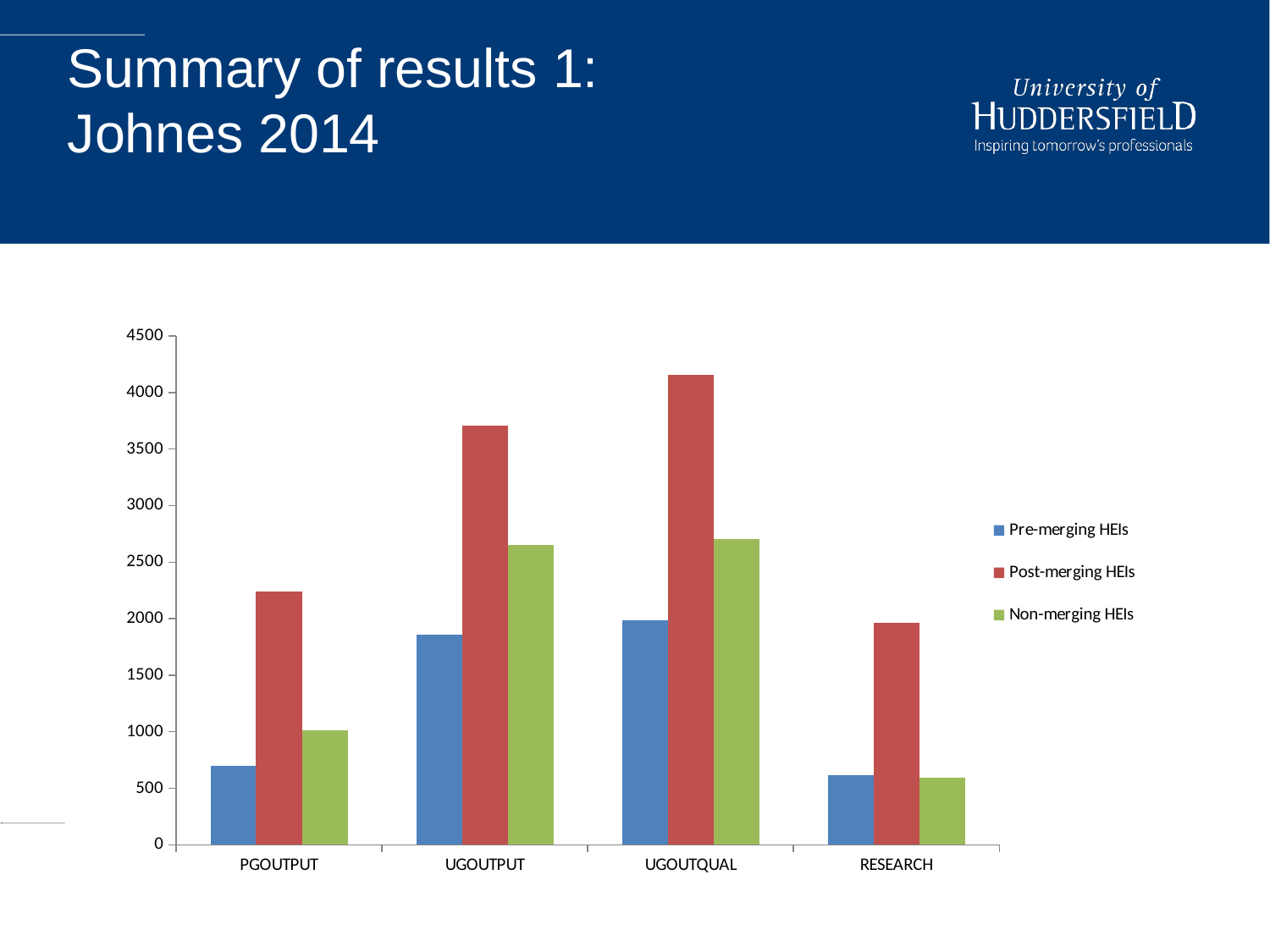
Is the Pre-merging HEIs value for PGOUTPUT greater or less than 1000? less Which series is shown in red in the legend? Post-merging HEIs How many categories are shown on the x axis? 4 Which category has the lowest Non-merging HEIs value? RESEARCH What kind of chart is shown on the slide? bar chart Which category has the highest Post-merging HEIs value? UGOUTQUAL For PGOUTPUT, which is larger: the Pre-merging HEIs value or the Non-merging HEIs value? Non-merging HEIs Which category has the lowest Pre-merging HEIs value? RESEARCH Is the Post-merging HEIs value for UGOUTQUAL greater or less than 4000? greater How many series does the legend list? 3 For UGOUTPUT, which is larger: the Post-merging HEIs value or the Non-merging HEIs value? Post-merging HEIs Is the Non-merging HEIs value for UGOUTPUT greater or less than 2500? greater